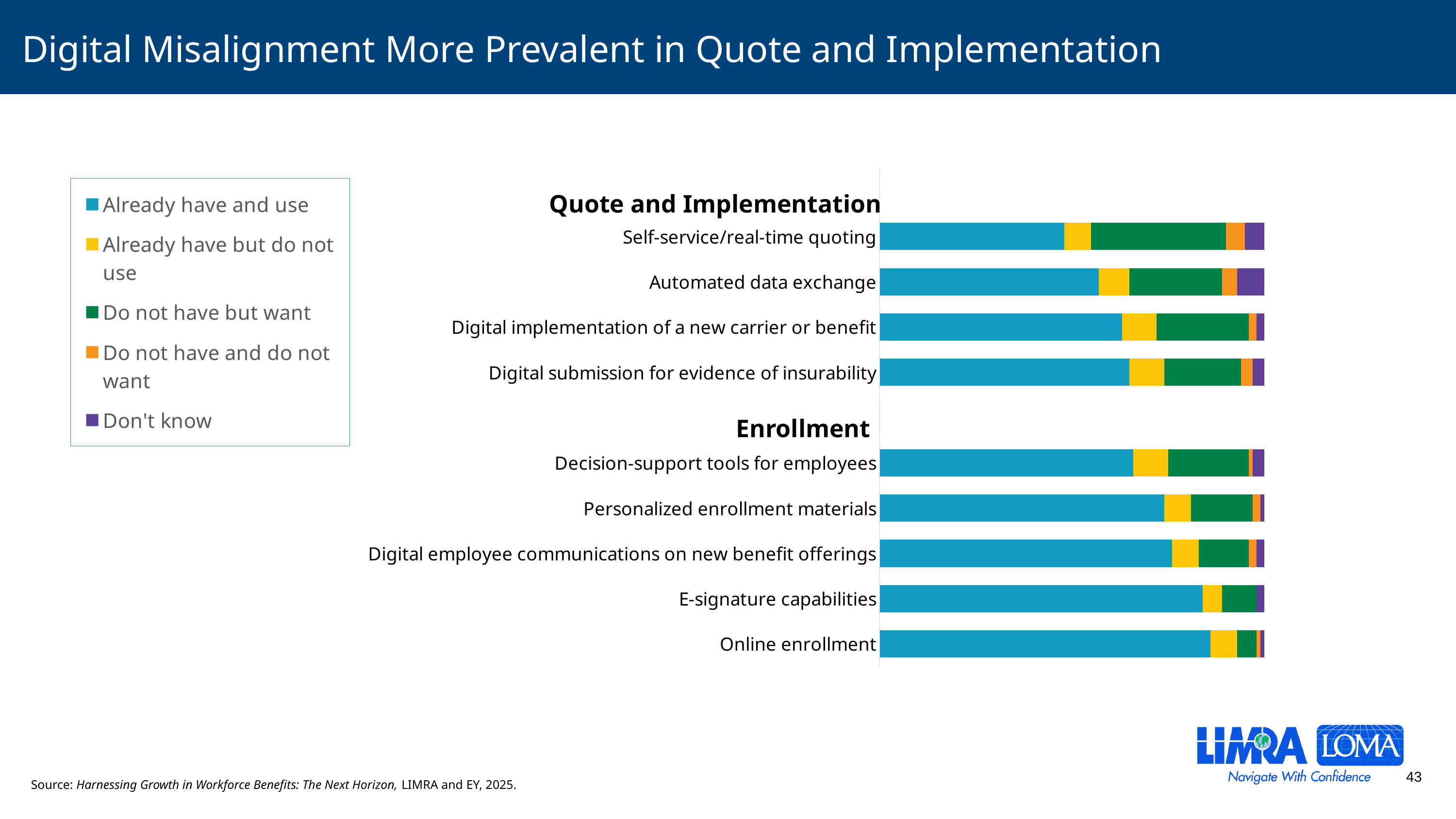
How many capabilities are listed under the Quote and Implementation group? 4 Which has the larger 'Already have and use' segment: Automated data exchange or Online enrollment? Online enrollment Which colour represents 'Do not have but want' in the legend? Green Which capability has the largest 'Already have and use' segment? Online enrollment Which capability has the largest 'Don't know' segment? Automated data exchange Which has the larger 'Do not have but want' segment: Self-service/real-time quoting or Online enrollment? Self-service/real-time quoting How many capabilities (bars) are plotted in the chart? 9 Which capability has the smallest 'Already have and use' segment? Self-service/real-time quoting How many series does the legend list? 5 How many capabilities are listed under the Enrollment group? 5 What kind of chart is shown on the slide? Stacked bar chart Which capability has the largest 'Do not have but want' segment? Self-service/real-time quoting